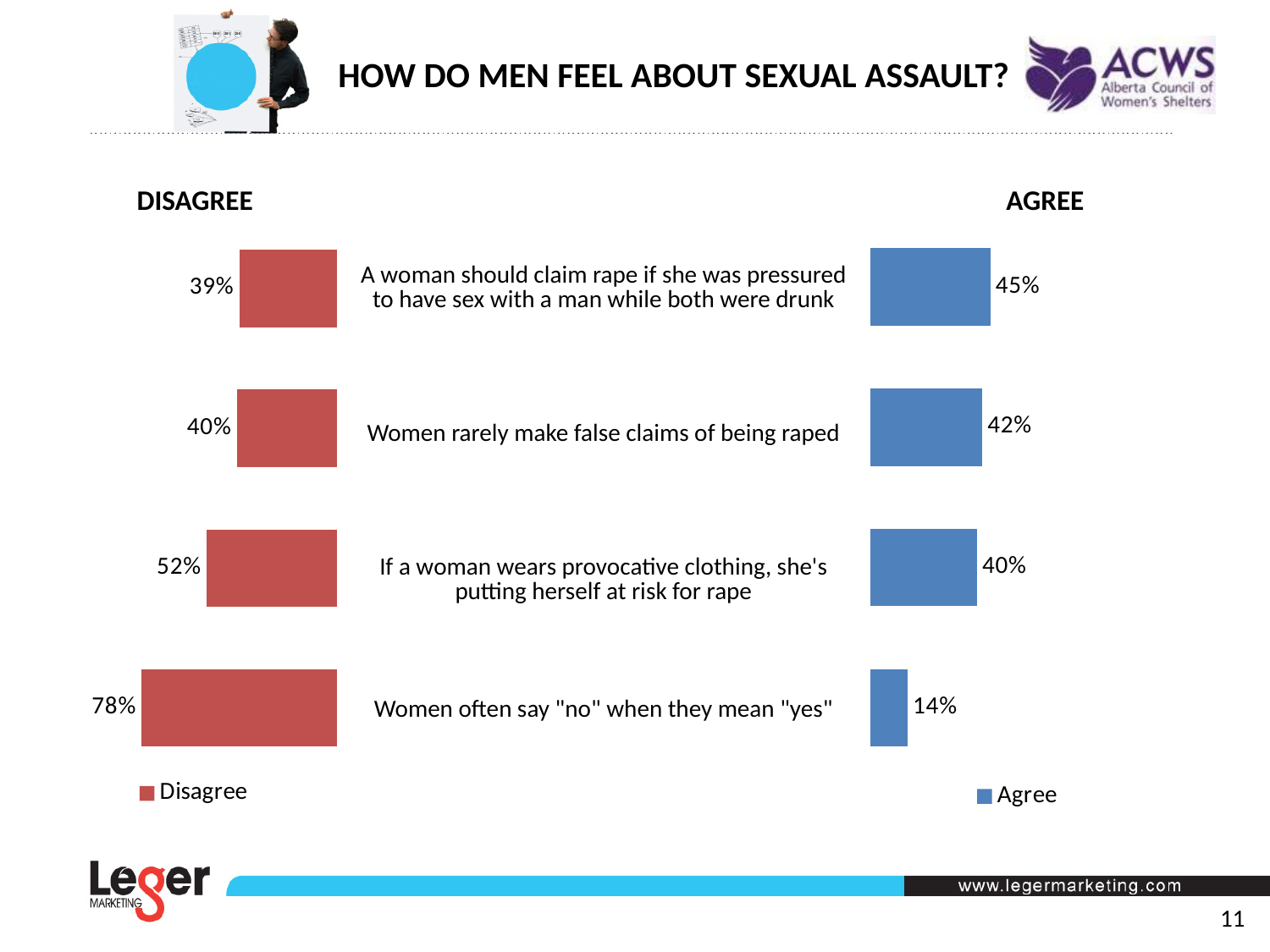
What is the Disagree value for the statement "If a woman wears provocative clothing, she's putting herself at risk for rape"? 52% What percentage of men disagree that women often say "no" when they mean "yes"? 78% What is the Agree value for the statement "A woman should claim rape if she was pressured to have sex with a man while both were drunk"? 45% What is the difference between the Disagree and Agree percentages for the statement "Women often say "no" when they mean "yes""? 64% What is the Agree value for the statement "Women rarely make false claims of being raped"? 42% Which statement has the highest Disagree percentage? Women often say "no" when they mean "yes" What percentage of men agree that women often say "no" when they mean "yes"? 14% What type of chart is shown on the slide? Bar chart How many series does the legend list? 2 Which statement has the lowest Agree percentage? Women often say "no" when they mean "yes" For the statement about provocative clothing, is the Disagree or Agree percentage larger? Disagree How many statements are shown in the chart? 4